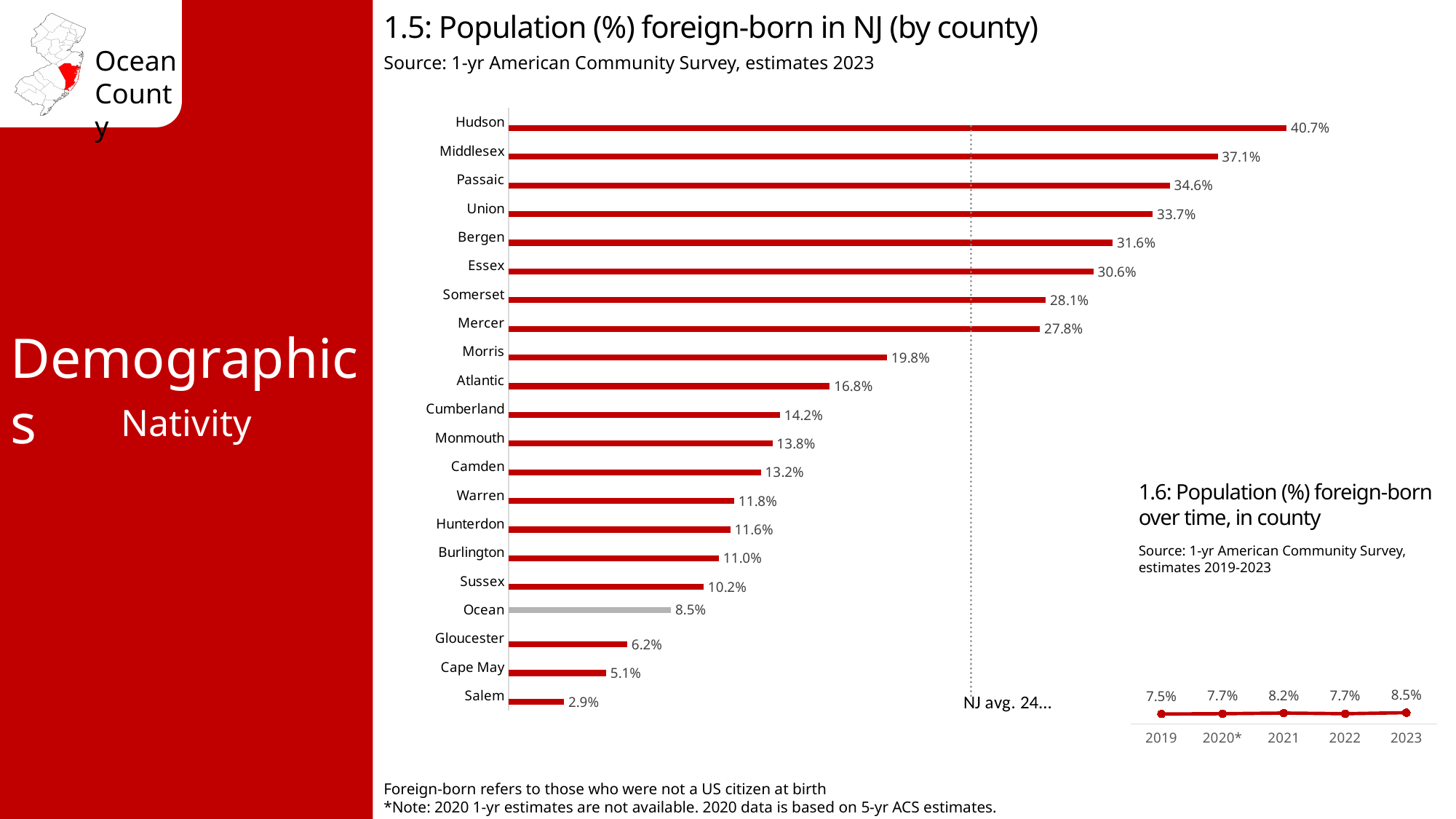
In chart 1.5, which county's bar is coloured grey instead of red? Ocean In chart 1.5, which county has a higher foreign-born percentage, Monmouth or Camden? Monmouth In chart 1.6, what was the foreign-born percentage in 2021? 8.2% In chart 1.5, what is the foreign-born percentage for Bergen? 31.6% In chart 1.5, how many counties are shown? 21 In chart 1.5, which county has the highest foreign-born percentage? Hudson In chart 1.5, which county has the lowest foreign-born percentage? Salem What kind of chart is chart 1.5? Bar chart In chart 1.6, which year has the highest foreign-born percentage? 2023 In chart 1.6, how many years are plotted? 5 In chart 1.5, what is the foreign-born percentage for Ocean County? 8.5% In chart 1.5, what is the difference between Hudson's and Middlesex's foreign-born percentages? 3.6%